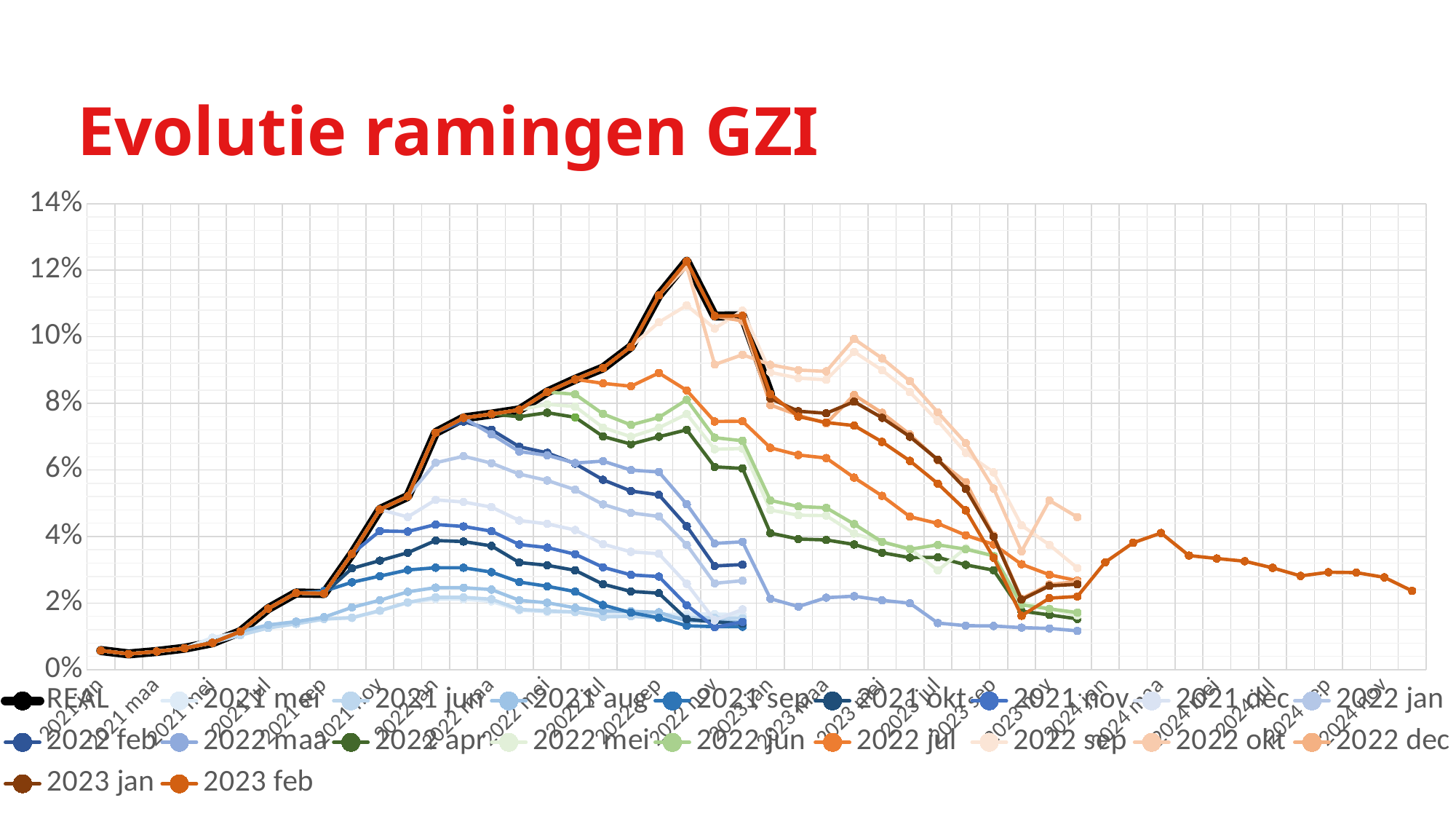
Does the REAL series rise or fall over its final points at the right end of the chart? fall Is the last plotted value of the REAL series greater or less than 4%? greater What kind of chart is shown on the slide? line chart What is the highest value shown on the vertical axis? 14% Which series is drawn in black? REAL Is the peak value of the REAL series greater or less than 10%? greater Is the peak of the 2021 mei series greater or less than 4%? less How many series does the legend list? 20 What is the title of the chart? Evolutie ramingen GZI